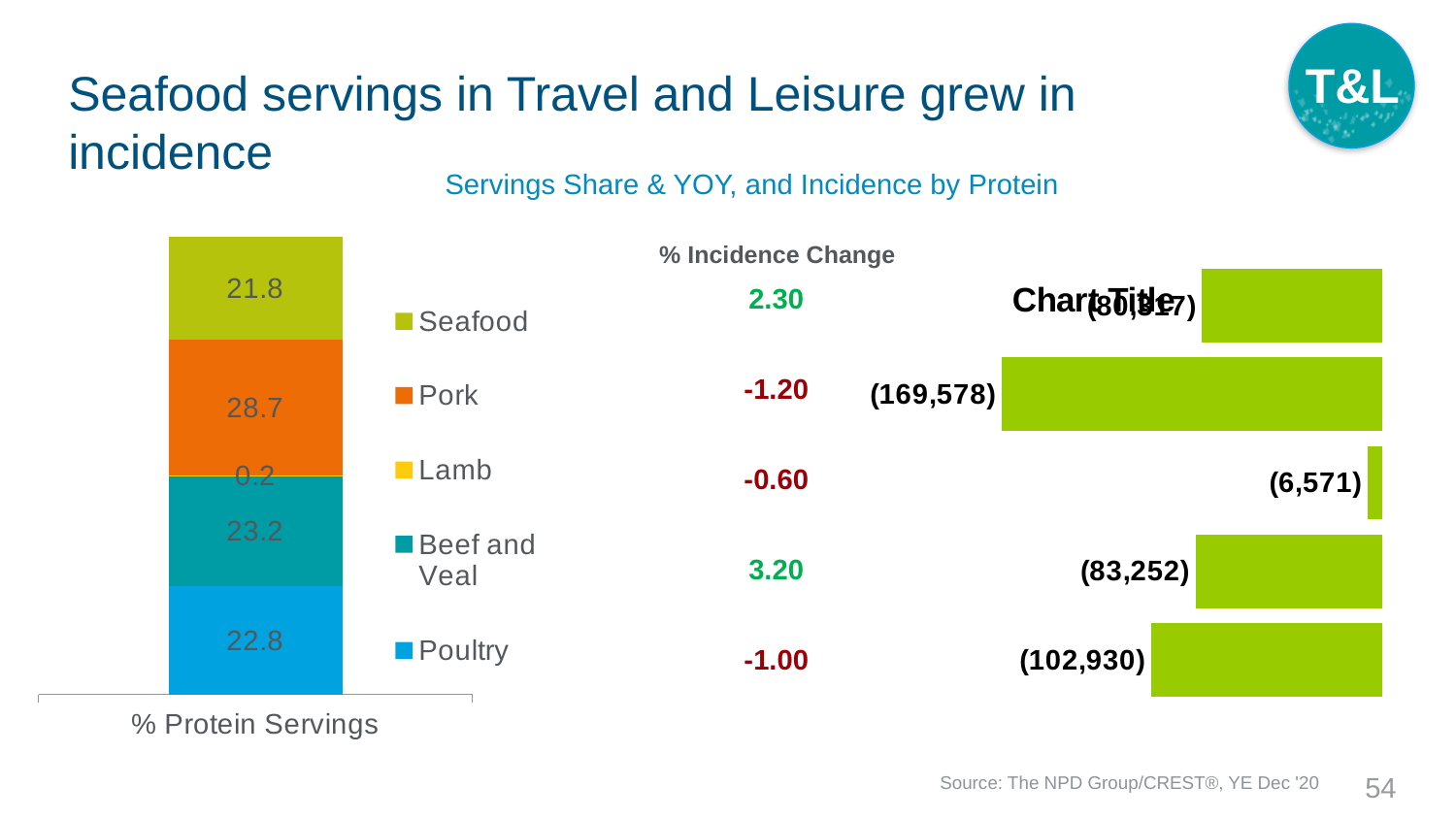
In the stacked bar chart on the left (% Protein Servings), which protein has the smallest share? Lamb In the stacked bar chart on the left (% Protein Servings), which is larger, Beef and Veal or Poultry? Beef and Veal In the stacked bar chart on the left (% Protein Servings), what is the value for Seafood? 21.8 What is the title shown on the right-hand bar chart? Chart Title In the stacked bar chart on the left (% Protein Servings), what is the value for Pork? 28.7 In the right-hand bar chart, what is the value of the shortest bar? (6,571) In the right-hand bar chart, what is the value of the second bar from the top? (169,578) What type of chart is the chart on the left of the slide (% Protein Servings)? Stacked bar chart In the stacked bar chart on the left (% Protein Servings), what is the total of all the segments? 96.7 In the stacked bar chart on the left (% Protein Servings), what is the difference between the Pork and Seafood values? 6.9 How many series does the legend of the left-hand stacked bar chart list? 5 In the stacked bar chart on the left (% Protein Servings), which protein has the largest share? Pork